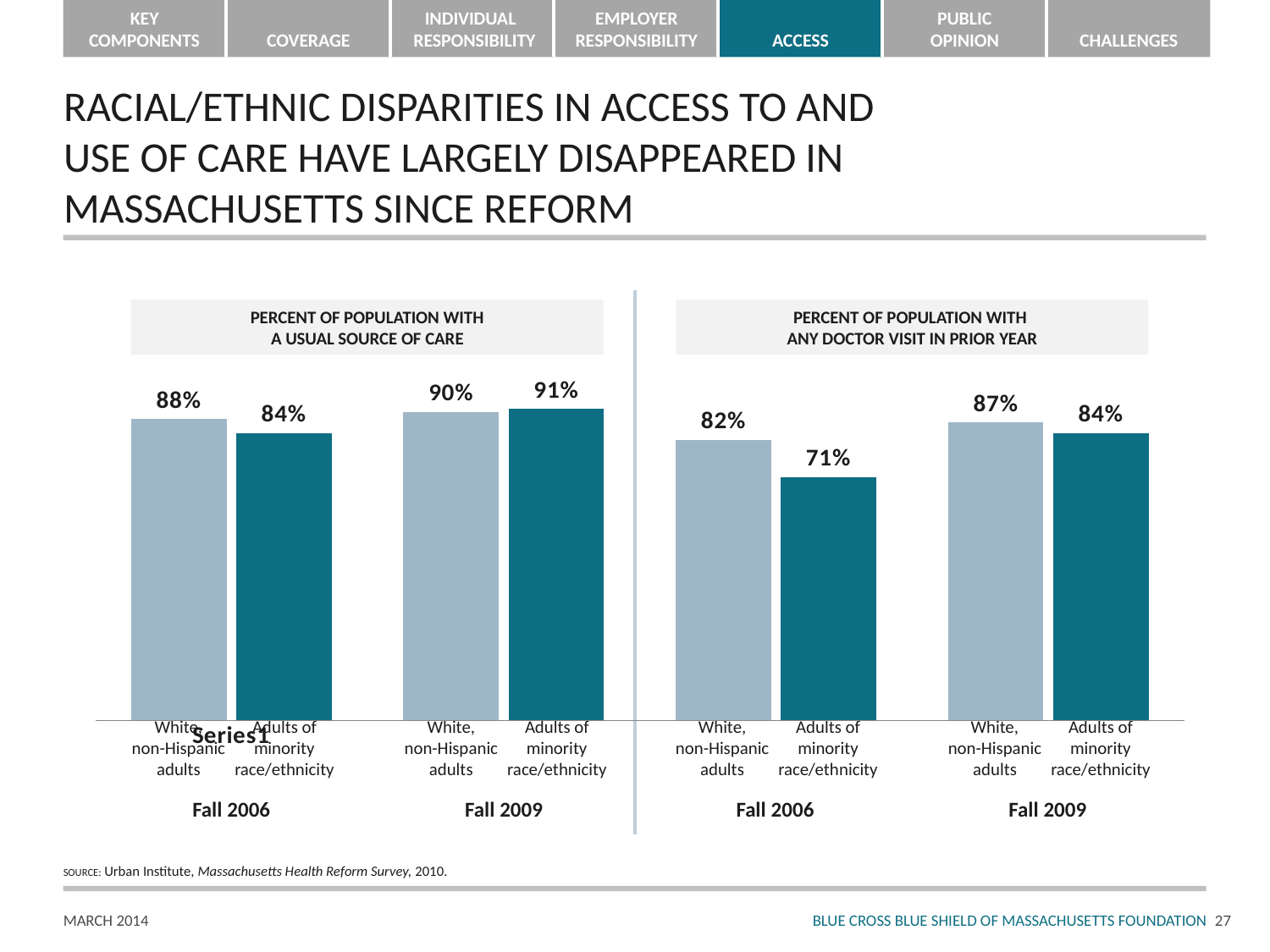
How many bars are shown in the chart titled "Percent of population with any doctor visit in prior year"? 4 In the chart titled "Percent of population with a usual source of care", did the value for adults of minority race/ethnicity rise or fall from Fall 2006 to Fall 2009? Rise In the chart titled "Percent of population with a usual source of care", what is the value for adults of minority race/ethnicity in Fall 2009? 91% In the chart titled "Percent of population with any doctor visit in prior year", which is larger in Fall 2009: White, non-Hispanic adults or adults of minority race/ethnicity? White, non-Hispanic adults In the chart titled "Percent of population with any doctor visit in prior year", which bar has the lowest value? Adults of minority race/ethnicity, Fall 2006 In the chart titled "Percent of population with any doctor visit in prior year", what is the value for adults of minority race/ethnicity in Fall 2006? 71% In the chart titled "Percent of population with a usual source of care", which bar has the highest value? Adults of minority race/ethnicity, Fall 2009 In the chart titled "Percent of population with any doctor visit in prior year", what is the value for White, non-Hispanic adults in Fall 2009? 87% What type of chart is used on this slide? Bar chart In the chart titled "Percent of population with any doctor visit in prior year", what is the difference between White, non-Hispanic adults and adults of minority race/ethnicity in Fall 2006? 11 percentage points In the chart titled "Percent of population with a usual source of care", what is the difference between White, non-Hispanic adults and adults of minority race/ethnicity in Fall 2006? 4 percentage points In the chart titled "Percent of population with a usual source of care", what is the value for White, non-Hispanic adults in Fall 2006? 88%